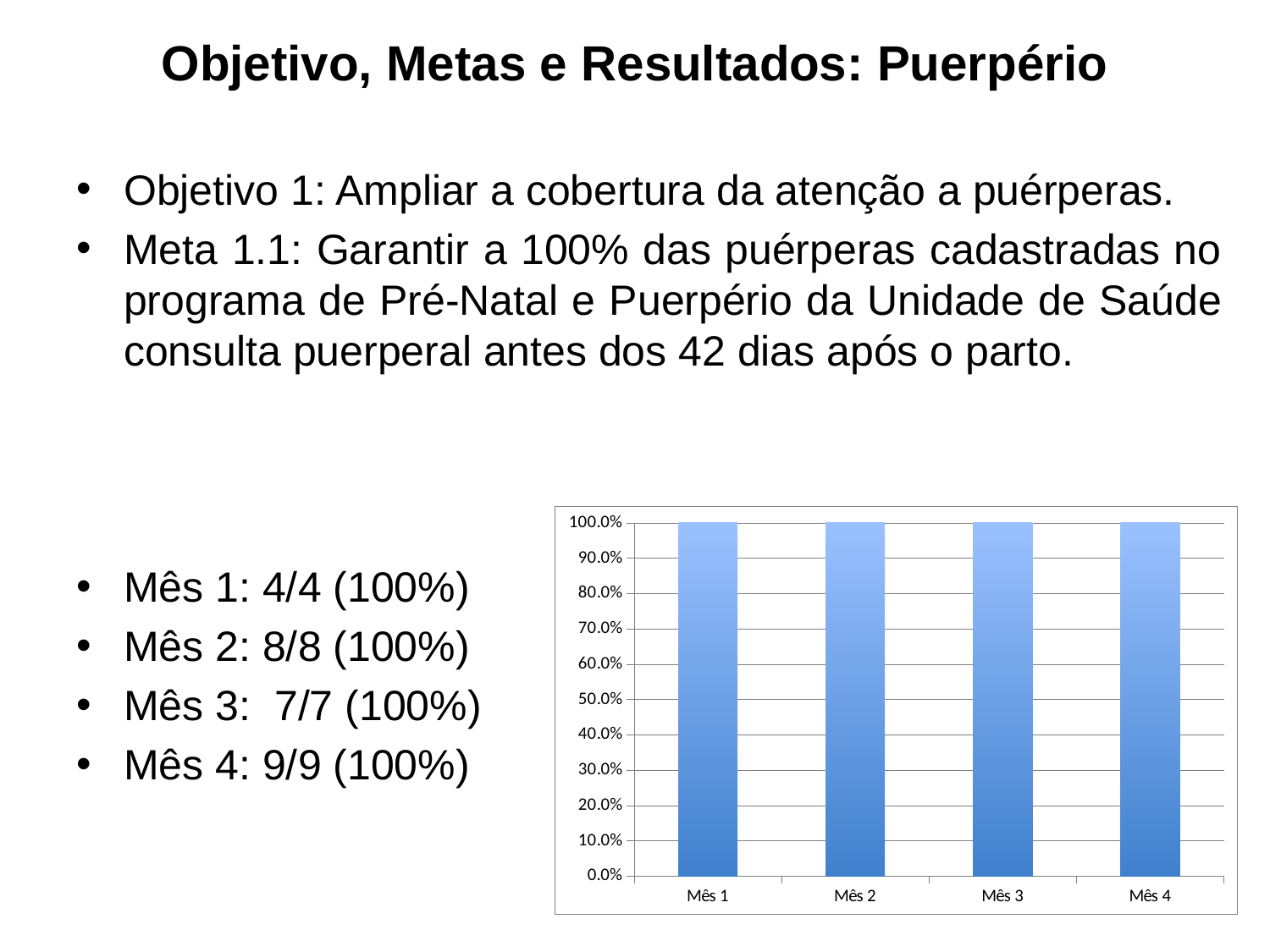
Is the value for Mês 1 greater or less than 50.0%? greater What is the label of the first category on the horizontal axis? Mês 1 What is the value of the bar for Mês 4? 100.0% What is the highest tick label shown on the vertical axis of the chart? 100.0% What is the value of the bar for Mês 1? 100.0% How many categories (months) are plotted on the chart? 4 What kind of chart is shown on the slide? bar chart Do the values rise, fall, or stay the same from Mês 1 to Mês 4? stay the same What is the difference between the values for Mês 4 and Mês 2? 0.0% What is the value of the bar for Mês 2? 100.0% Is the value for Mês 3 greater or less than 90.0%? greater What is the value of the bar for Mês 3? 100.0%